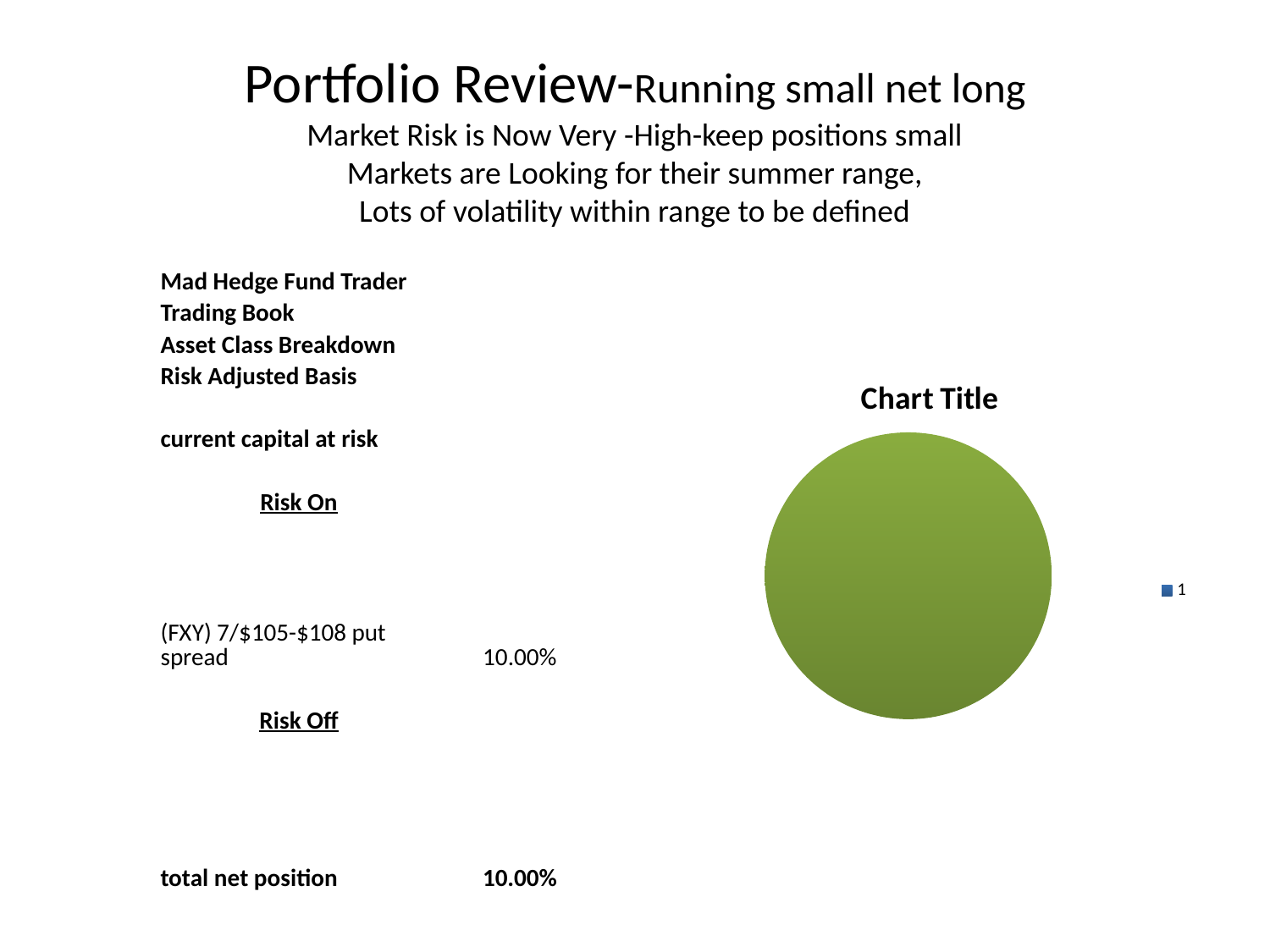
What kind of chart is shown on the slide? pie chart How many slices does the pie chart have? 1 What share of the pie does the single slice occupy? 100% What is the label of the only legend entry in the chart? 1 How many entries does the chart's legend list? 1 What is the title of the chart on the slide? Chart Title